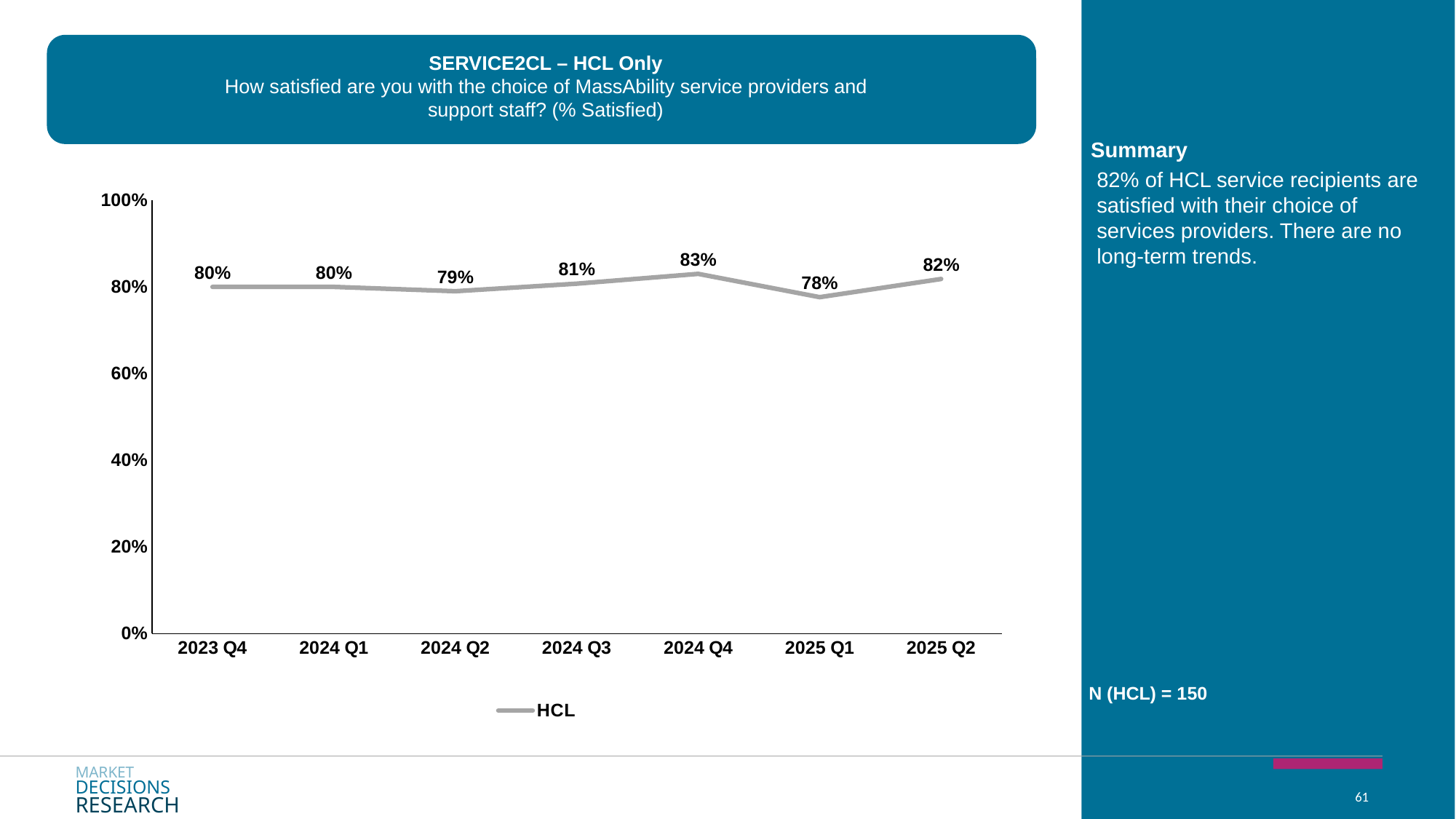
Which quarter has the highest value? 2024 Q4 How many quarters are plotted on the x axis? 7 What is the value for 2024 Q4? 83% Which is larger, the value for 2024 Q3 or the value for 2025 Q2? 2025 Q2 What is the value for 2023 Q4? 80% Is the value for 2024 Q2 greater or less than 60%? greater What is the difference between the values for 2024 Q4 and 2025 Q1? 5% What kind of chart is shown? line chart What is the value for 2025 Q1? 78% Which quarter has the lowest value? 2025 Q1 How many series does the legend list? 1 What is the name of the series shown in the legend? HCL